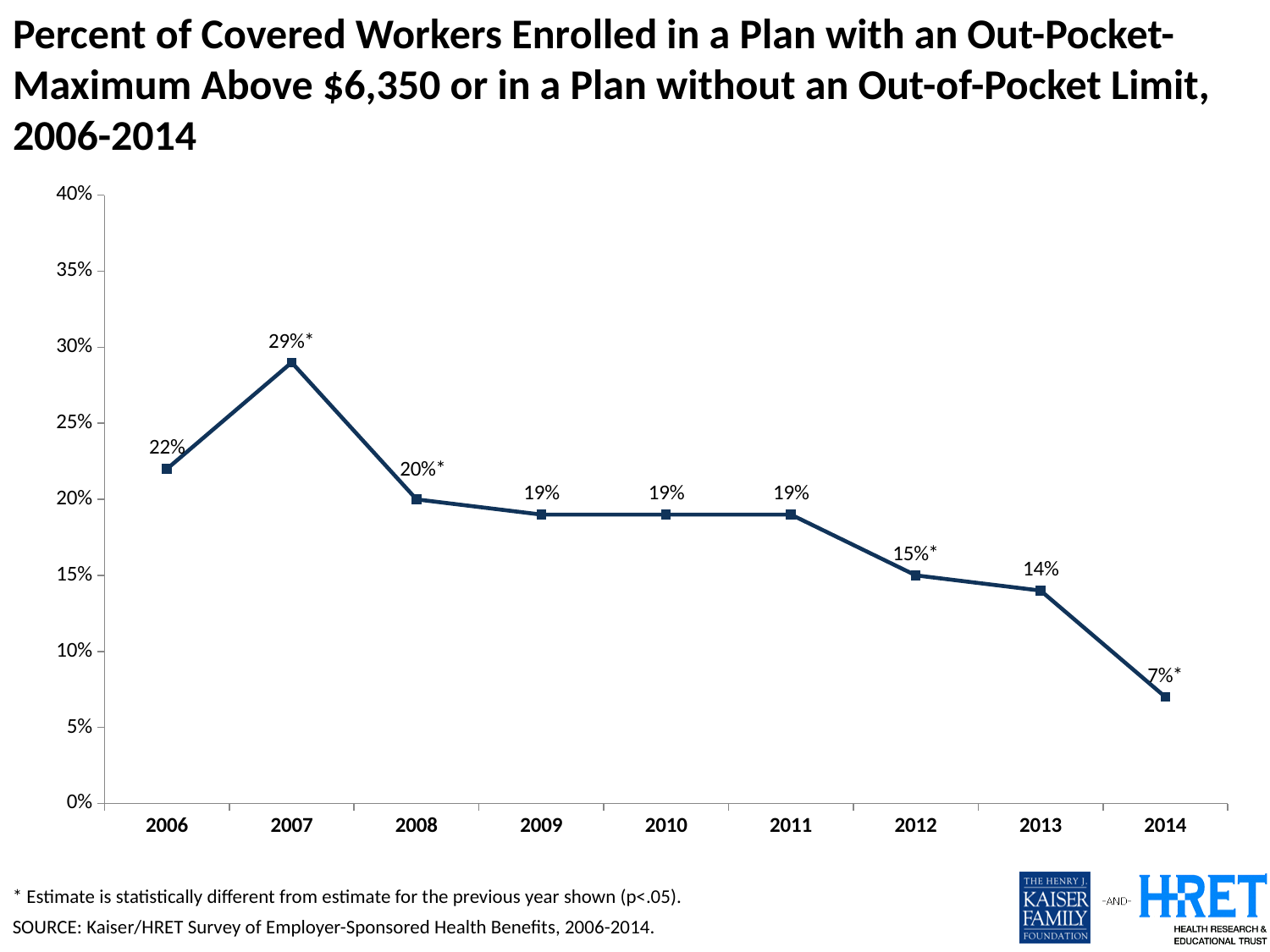
What is the value for 2014? 7% What is the difference between the values for 2006 and 2014? 15% Do the values rise or fall from 2008 to 2014? fall Which year has the highest value? 2007 What kind of chart is shown on the slide? line chart What is the value for 2012? 15% Is the value for 2007 greater or less than 25%? greater What is the difference between the values for 2007 and 2008? 9% How many years are plotted on the chart? 9 Which year has the lowest value? 2014 What is the value for 2007? 29% Which is larger, the value for 2006 or the value for 2013? 2006